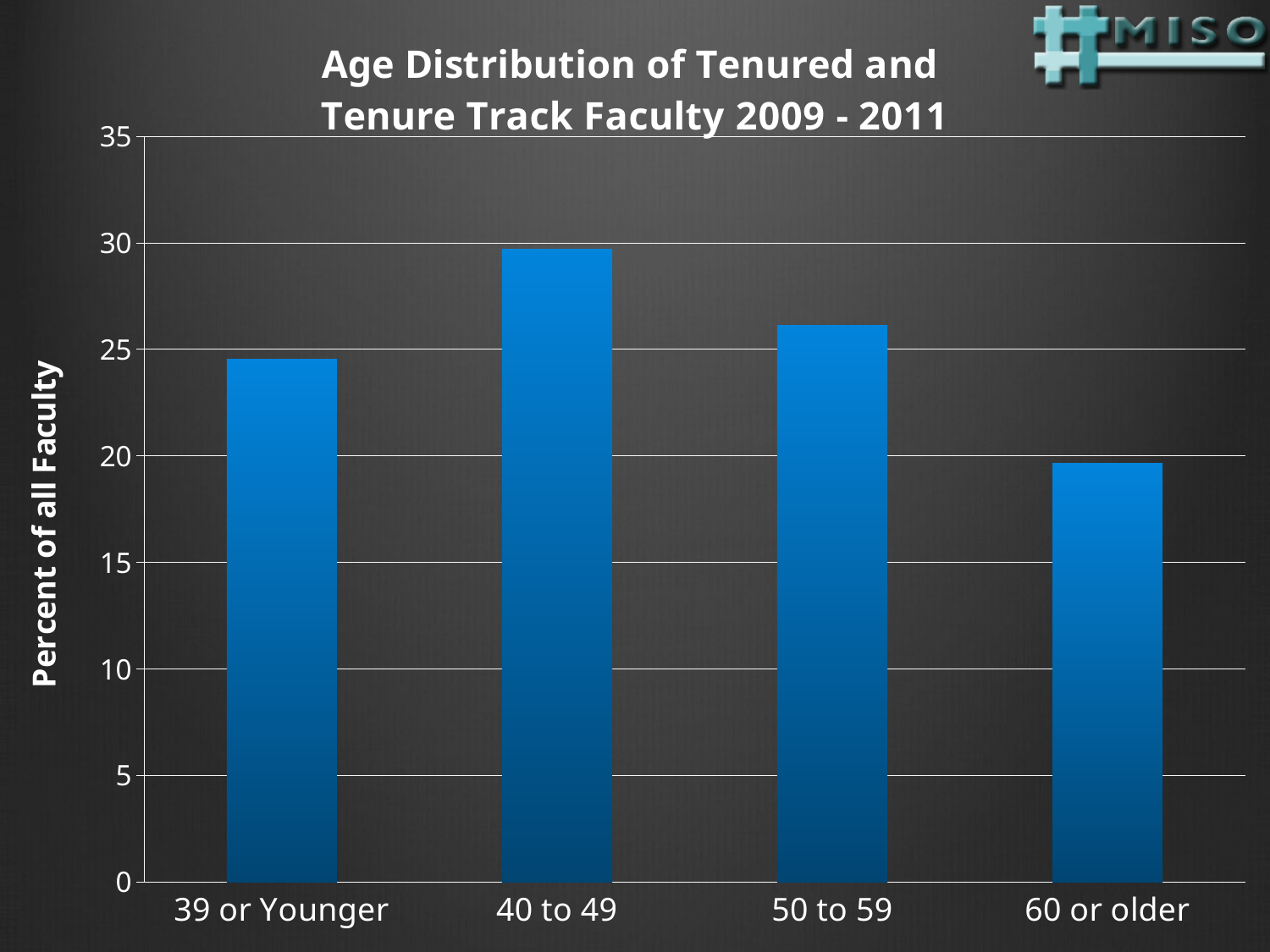
Is the value for 60 or older greater or less than 15? greater What is the label on the vertical axis? Percent of all Faculty Which age group has the lowest percent of all faculty? 60 or older Is the value for 39 or Younger greater or less than 20? greater What is the title of the chart? Age Distribution of Tenured and Tenure Track Faculty 2009 - 2011 How many age categories are shown on the x axis? 4 Which age group has the highest percent of all faculty? 40 to 49 What kind of chart is shown on the slide? Bar chart Is the value for 40 to 49 greater or less than 25? greater Which is larger, the value for 40 to 49 or the value for 50 to 59? 40 to 49 Which is larger, the value for 39 or Younger or the value for 60 or older? 39 or Younger